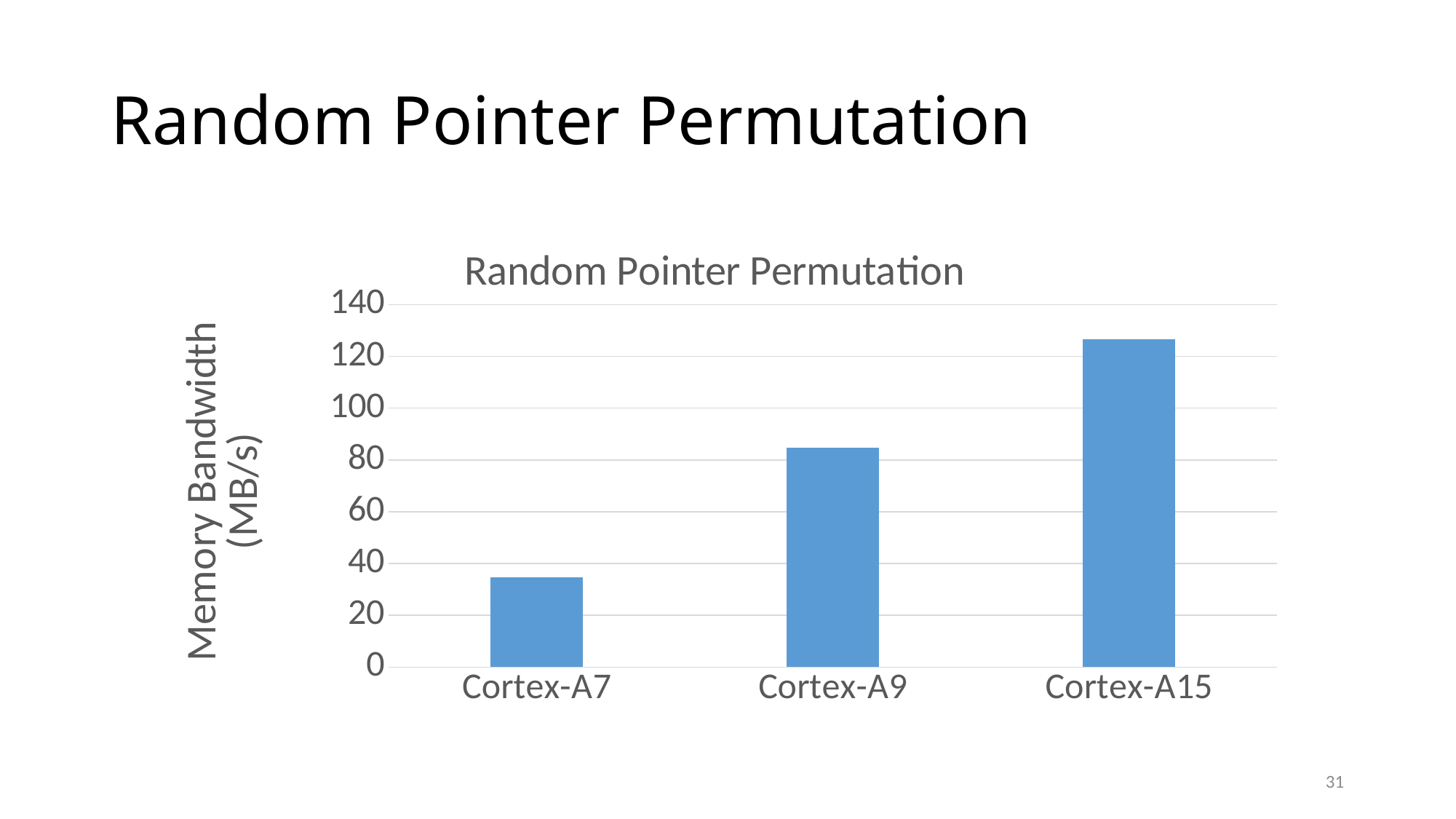
Is the value for Cortex-A7 greater or less than 40? less Do the values rise or fall from Cortex-A7 to Cortex-A15 along the x axis? rise What is the label of the y axis? Memory Bandwidth (MB/s) Which has a higher memory bandwidth, Cortex-A15 or Cortex-A9? Cortex-A15 Is the value for Cortex-A9 greater or less than 80? greater Which category has the highest memory bandwidth? Cortex-A15 How many categories are shown on the x axis? 3 Which has a higher memory bandwidth, Cortex-A9 or Cortex-A7? Cortex-A9 Which category has the lowest memory bandwidth? Cortex-A7 Is the value for Cortex-A15 greater or less than 120? greater What kind of chart is shown on the slide? bar chart